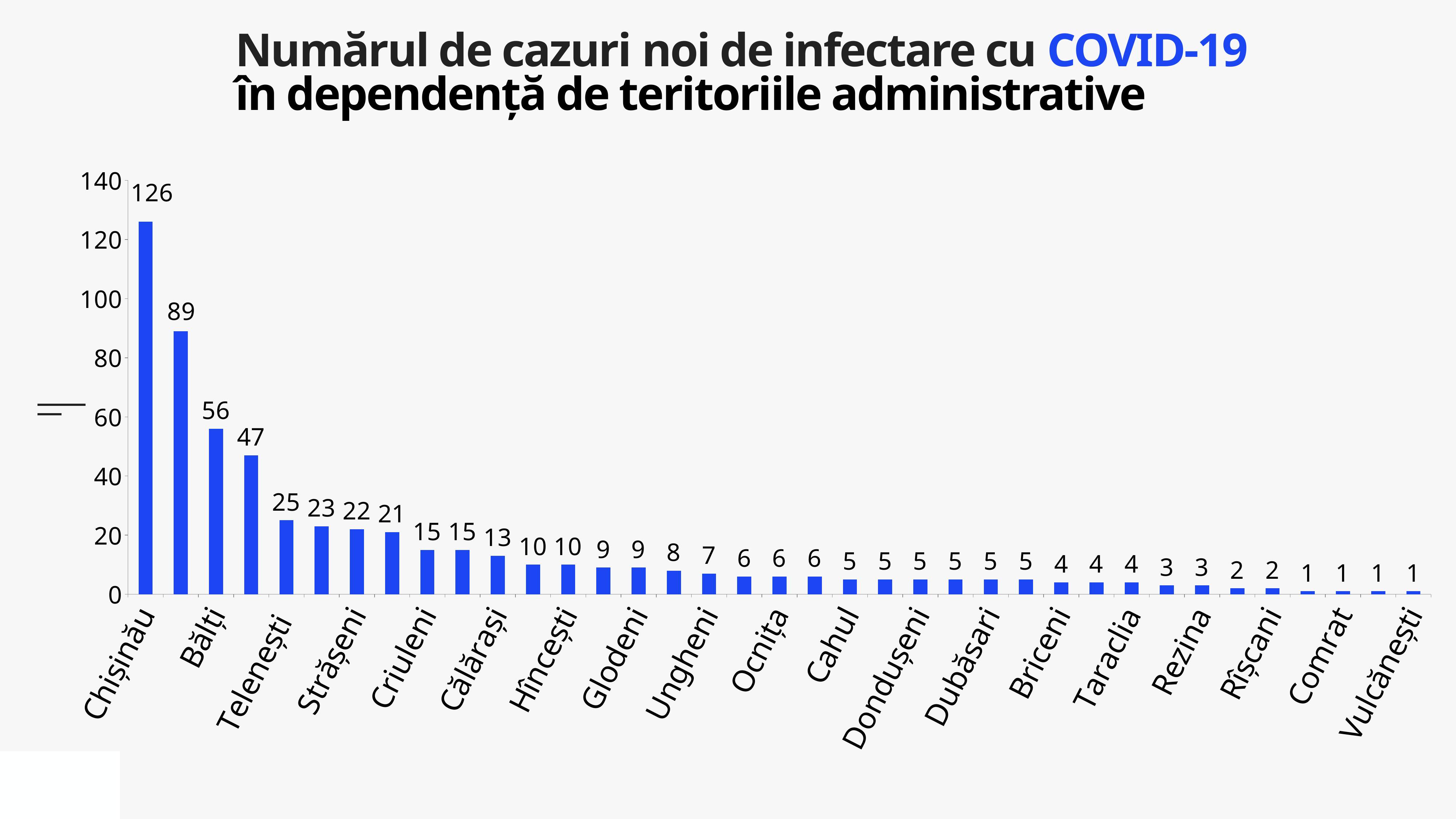
What is the smallest value labelled on any bar in the chart? 1 Do the values rise or fall moving from left to right along the x axis? fall What is the highest tick value shown on the vertical axis? 140 What is the difference between the two tallest bars (126 and 89)? 37 What colour are the bars in the chart? blue Is the value for Chișinău greater or less than 120? greater What is the value of the second-tallest bar in the chart? 89 Which territory has the highest number of new COVID-19 cases? Chișinău What kind of chart is shown on the slide? bar chart Which is larger, the value for Chișinău or the value of the second bar (89)? Chișinău What is the value shown for Chișinău? 126